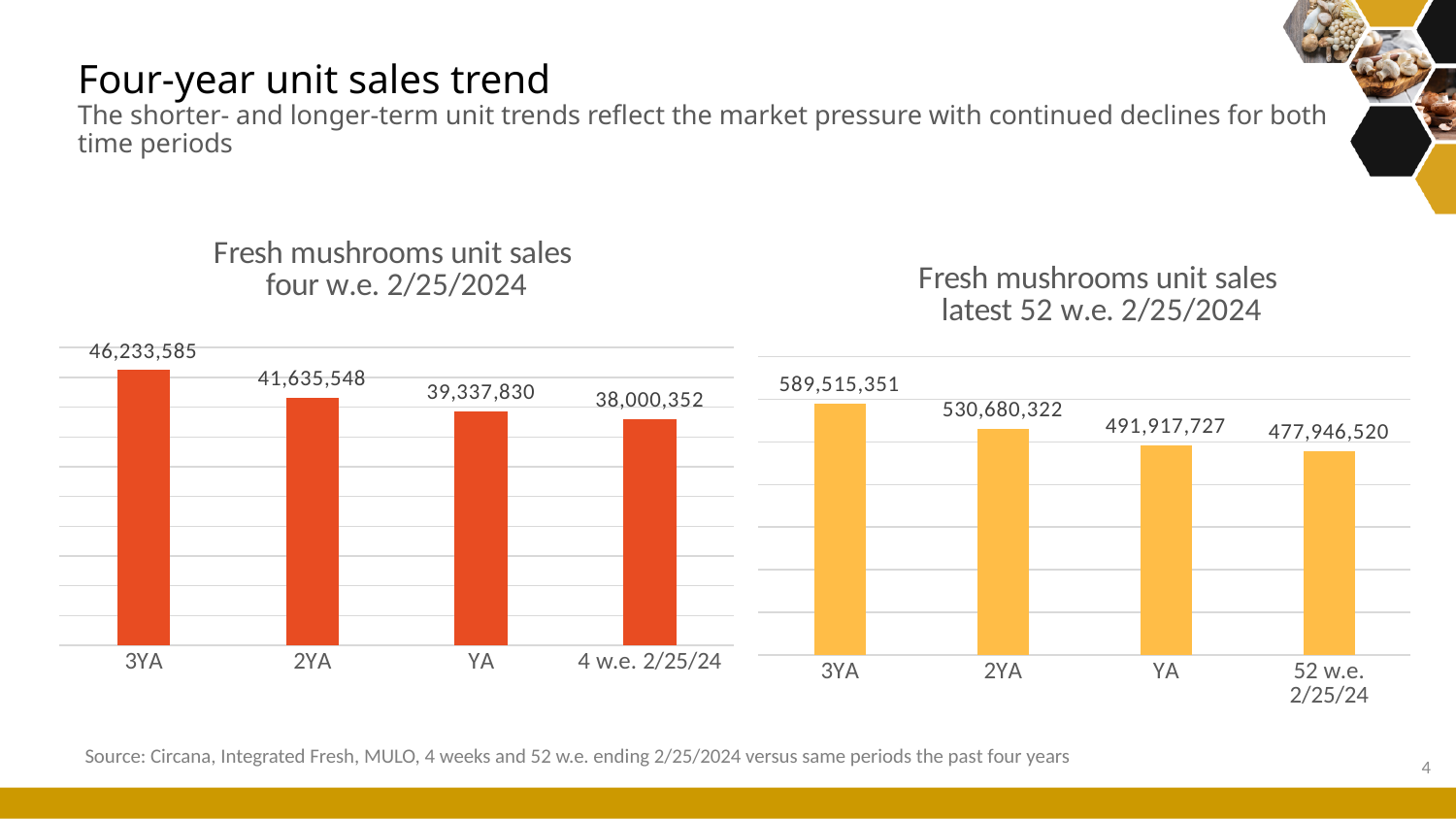
In the 'Fresh mushrooms unit sales four w.e. 2/25/2024' chart, what is the value for 3YA? 46,233,585 What kind of chart is the 'Fresh mushrooms unit sales latest 52 w.e. 2/25/2024' chart? Bar chart In the 'Fresh mushrooms unit sales latest 52 w.e. 2/25/2024' chart, which category has the lowest value? 52 w.e. 2/25/24 In the 'Fresh mushrooms unit sales latest 52 w.e. 2/25/2024' chart, which is larger, the value for 3YA or the value for YA? 3YA In the 'Fresh mushrooms unit sales four w.e. 2/25/2024' chart, what is the difference between the 3YA value and the 4 w.e. 2/25/24 value? 8,233,233 How many categories are shown in the 'Fresh mushrooms unit sales four w.e. 2/25/2024' chart? 4 In the 'Fresh mushrooms unit sales latest 52 w.e. 2/25/2024' chart, what is the value for 2YA? 530,680,322 In the 'Fresh mushrooms unit sales four w.e. 2/25/2024' chart, what is the value for 4 w.e. 2/25/24? 38,000,352 In the 'Fresh mushrooms unit sales latest 52 w.e. 2/25/2024' chart, what is the value for 52 w.e. 2/25/24? 477,946,520 In the 'Fresh mushrooms unit sales latest 52 w.e. 2/25/2024' chart, what is the difference between the 2YA value and the YA value? 38,762,595 In the 'Fresh mushrooms unit sales four w.e. 2/25/2024' chart, which category has the highest value? 3YA In the 'Fresh mushrooms unit sales four w.e. 2/25/2024' chart, do the values rise or fall from 3YA to 4 w.e. 2/25/24? Fall